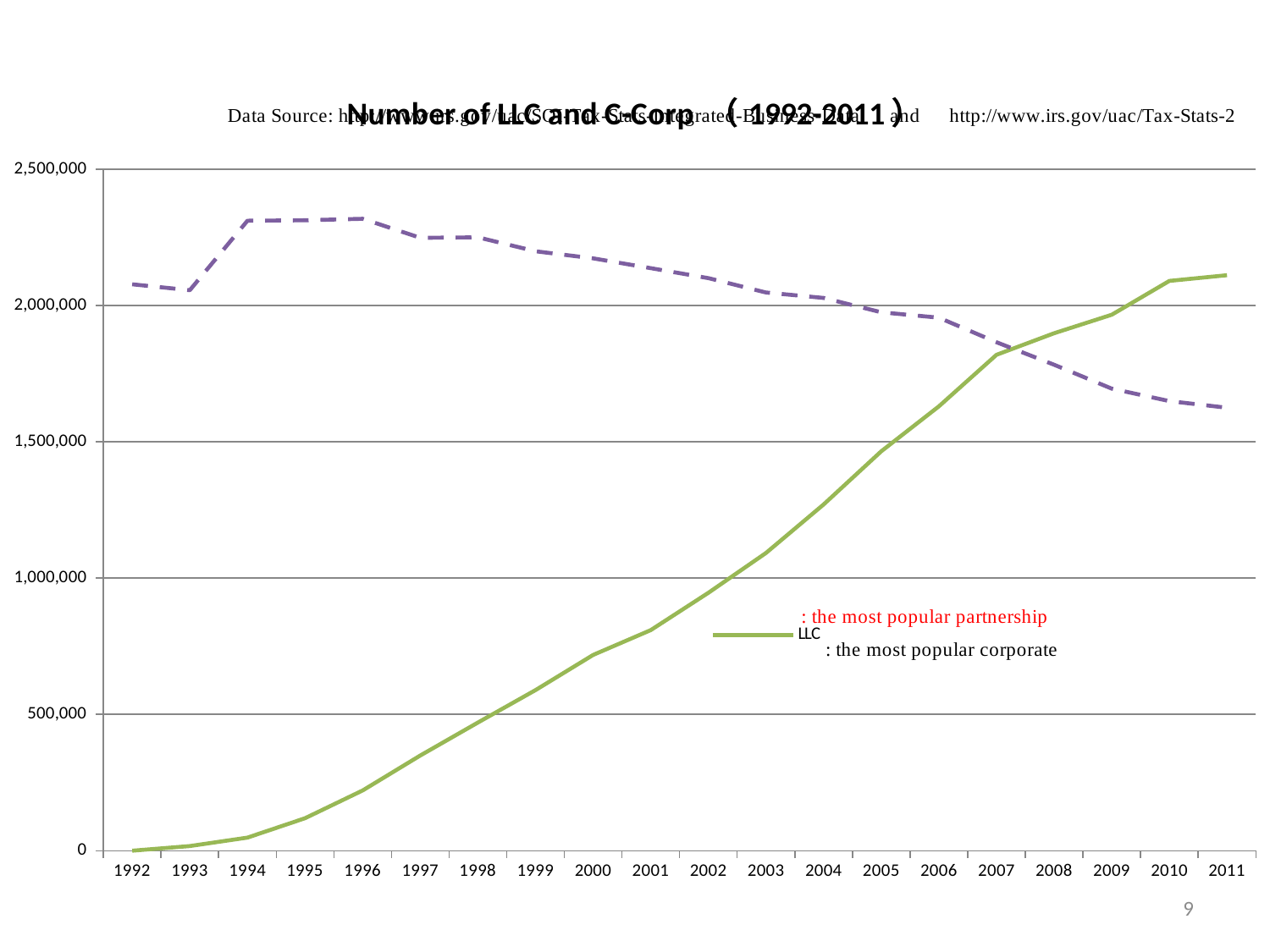
What kind of chart is shown on the slide? line chart How many years are shown along the x axis of the chart? 20 How many lines are plotted on the chart? 2 In 2011, which is larger, the LLC value or the C-Corp value? LLC In 1992, which is larger, the LLC value or the C-Corp value? C-Corp Is the LLC value in 2011 greater or less than 2,000,000? greater Does the dashed C-Corp line rise or fall from 1996 to 2011? falls In which year is the LLC value lowest? 1992 Does the LLC line rise or fall from 1992 to 2011? rises Is the LLC value in 2007 greater or less than 1,500,000? greater Is the LLC value in 2000 greater or less than 1,000,000? less